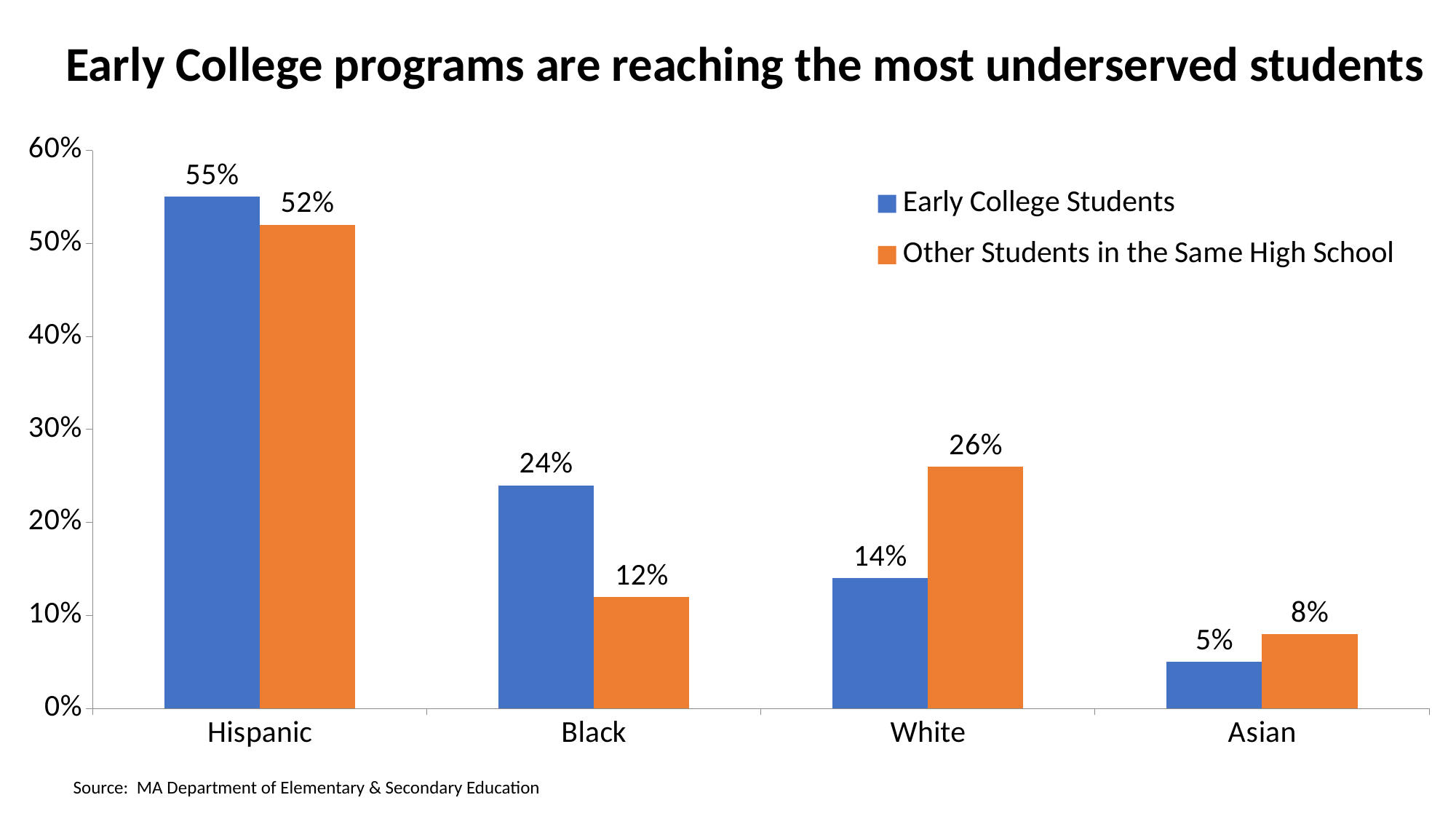
What kind of chart is shown on the slide? Bar chart What is the value for Other Students in the Same High School in the White category? 26% In the White category, which series has the larger value: Early College Students or Other Students in the Same High School? Other Students in the Same High School How many series does the legend list? 2 What is the title of the chart? Early College programs are reaching the most underserved students Which category has the highest value for Early College Students? Hispanic Which category has the lowest value for Other Students in the Same High School? Asian What is the value for Early College Students in the Asian category? 5% What colour represents Early College Students in the chart? Blue What is the difference between Early College Students and Other Students in the Same High School in the Black category? 12% What is the value for Early College Students in the Hispanic category? 55% How many categories are shown on the x axis? 4